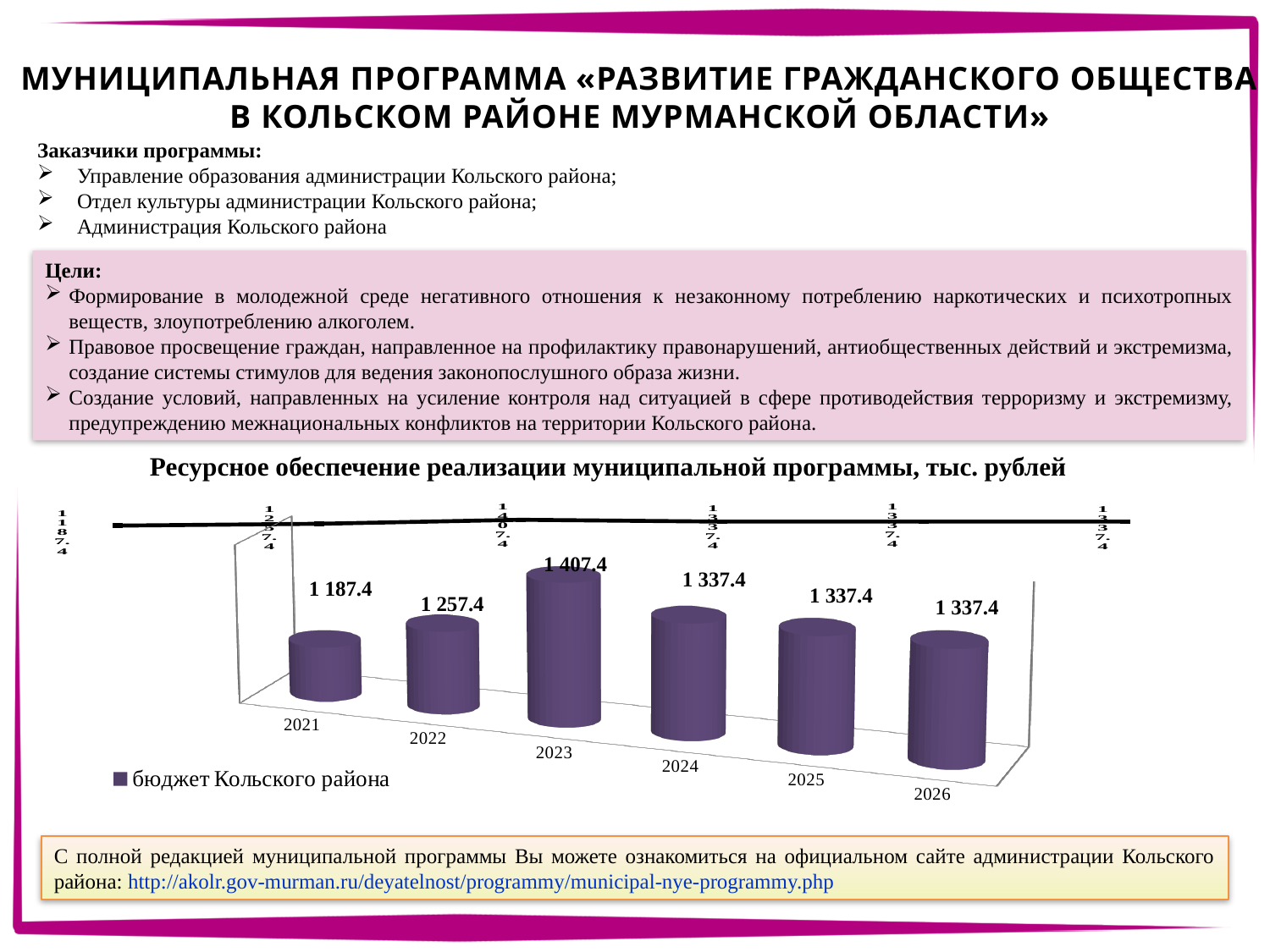
What is the value for 2021 in the chart? 1 187.4 What kind of chart is shown on the slide? bar chart What is the difference between the values for 2022 and 2021? 70 Which year has the highest value in the chart? 2023 How many series does the chart legend list? 1 How many years are shown on the x axis of the chart? 6 What is the difference between the values for 2023 and 2021? 220 What is the value for 2025 in the chart? 1 337.4 Which year has the lowest value in the chart? 2021 Which is larger, the value for 2022 or the value for 2024? 2024 What is the legend entry of the chart? бюджет Кольского района What is the value for 2023 in the chart? 1 407.4